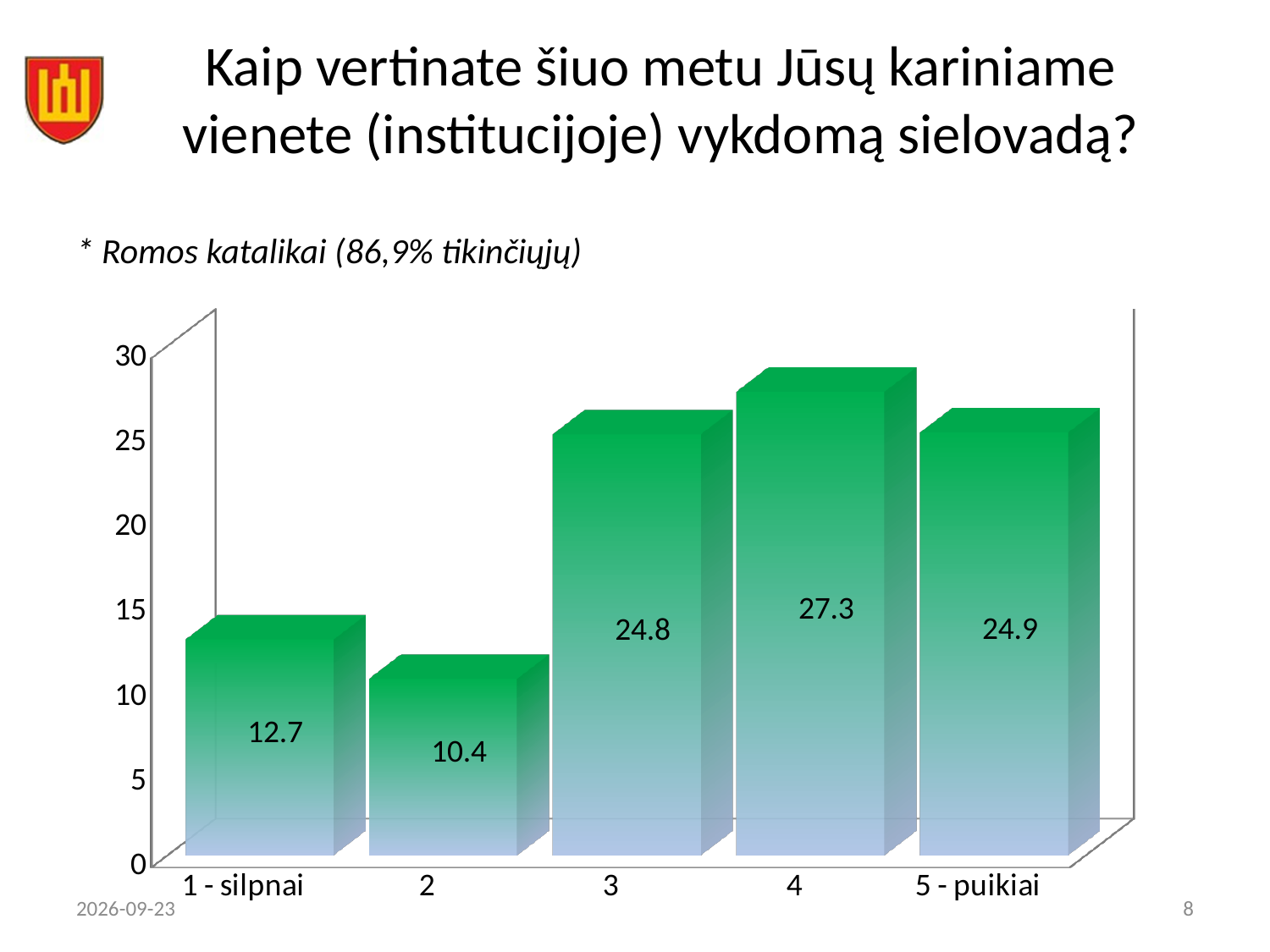
What is the value for category "3"? 24.8 Which is larger, the value for "1 - silpnai" or the value for "2"? 1 - silpnai What is the note printed above the chart? * Romos katalikai (86,9% tikinčiųjų) Which category has the highest value? 4 How many categories are shown on the x axis? 5 What is the value for the category "5 - puikiai"? 24.9 What is the value for category "2"? 10.4 What is the value for the category "1 - silpnai"? 12.7 What is the value for category "4"? 27.3 Which category has the lowest value? 2 What kind of chart is shown on the slide? bar chart What is the difference between the values for category "4" and category "2"? 16.9